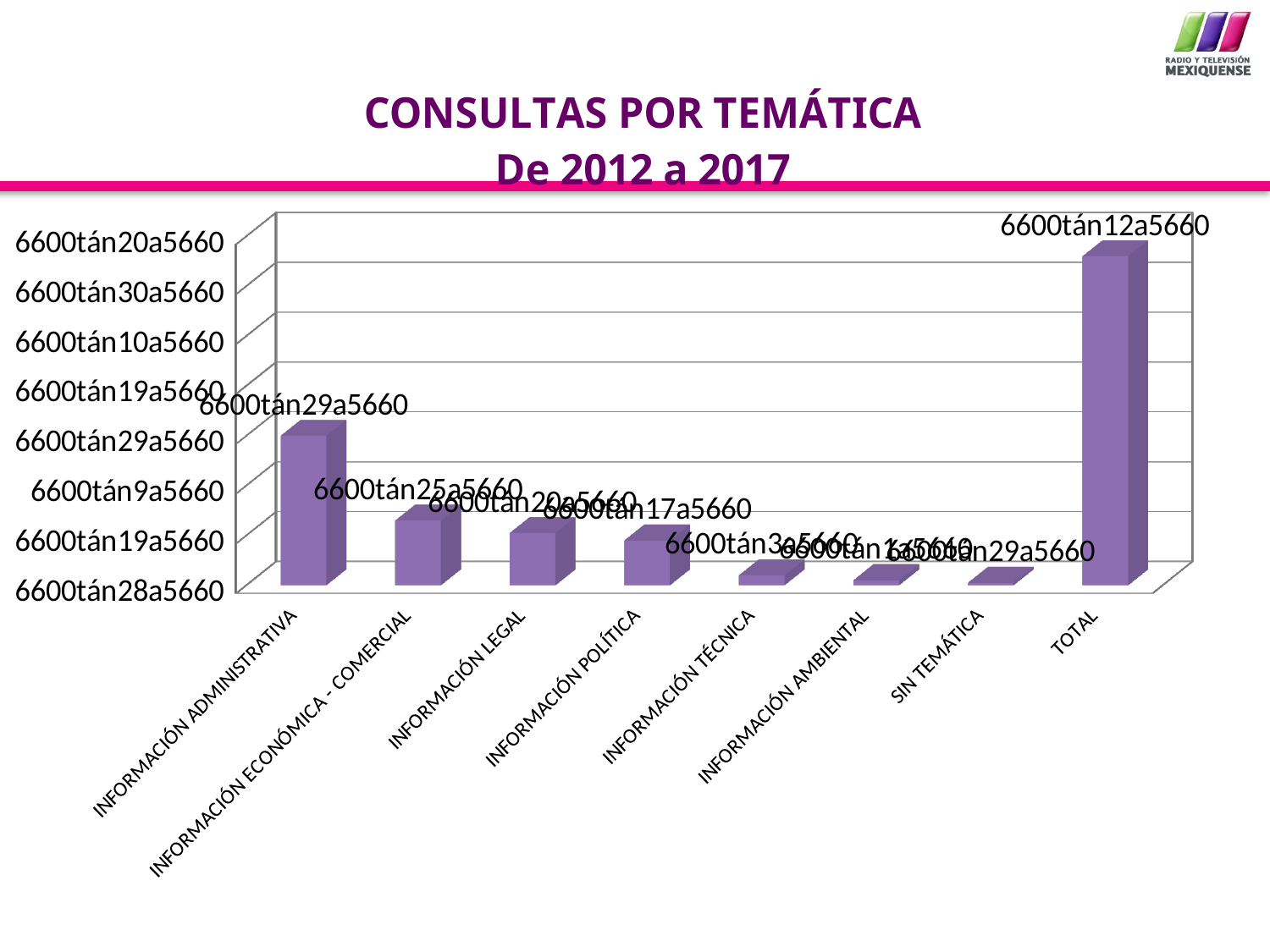
Excluding TOTAL, which category has the tallest bar? INFORMACIÓN ADMINISTRATIVA Do the bars rise or fall from INFORMACIÓN ADMINISTRATIVA to SIN TEMÁTICA along the x axis? fall Which bar is taller: INFORMACIÓN LEGAL or INFORMACIÓN TÉCNICA? INFORMACIÓN LEGAL Which category has the shortest bar in the chart? SIN TEMÁTICA Which bar is taller: INFORMACIÓN POLÍTICA or INFORMACIÓN AMBIENTAL? INFORMACIÓN POLÍTICA What is the title of the chart on the slide? CONSULTAS POR TEMÁTICA De 2012 a 2017 How many categories are shown on the x axis of the chart? 8 What kind of chart is shown on the slide? bar chart Which category has the tallest bar in the chart? TOTAL What colour are the bars in the chart? purple Which bar is taller: INFORMACIÓN ADMINISTRATIVA or INFORMACIÓN ECONÓMICA - COMERCIAL? INFORMACIÓN ADMINISTRATIVA